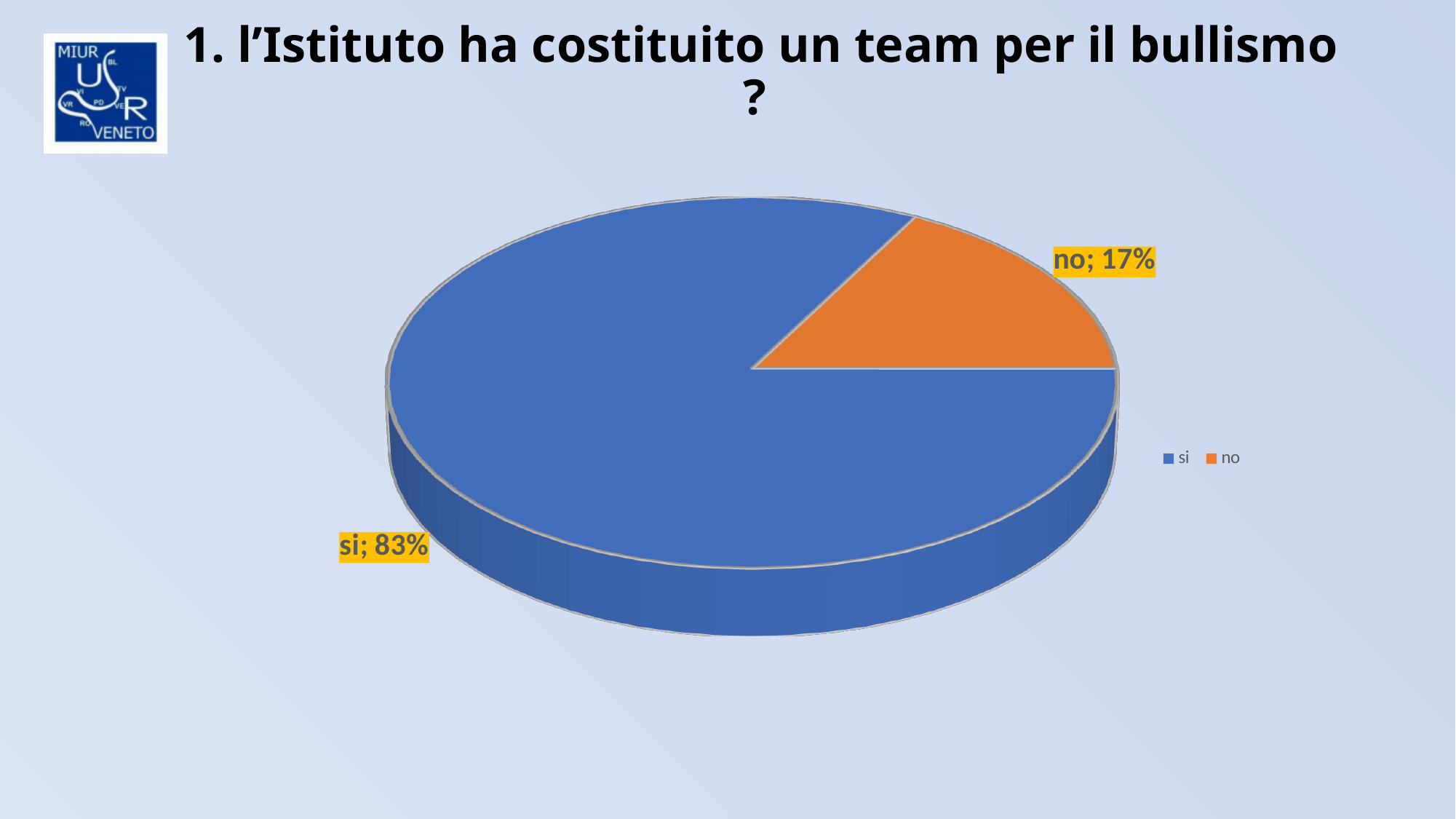
What colour is the "no" slice? orange What kind of chart is shown on the slide? pie chart How many slices does the pie chart have? 2 Which slice is the largest in the pie chart? si What is the difference in percentage points between the "si" and "no" slices? 66% How many entries does the legend list? 2 What is the title of the slide above the chart? 1. l'Istituto ha costituito un team per il bullismo ? What share of the pie does the "no" slice represent? 17% What share of the pie does the "si" slice represent? 83% Which is larger, the "si" slice or the "no" slice? si Which slice is the smallest in the pie chart? no